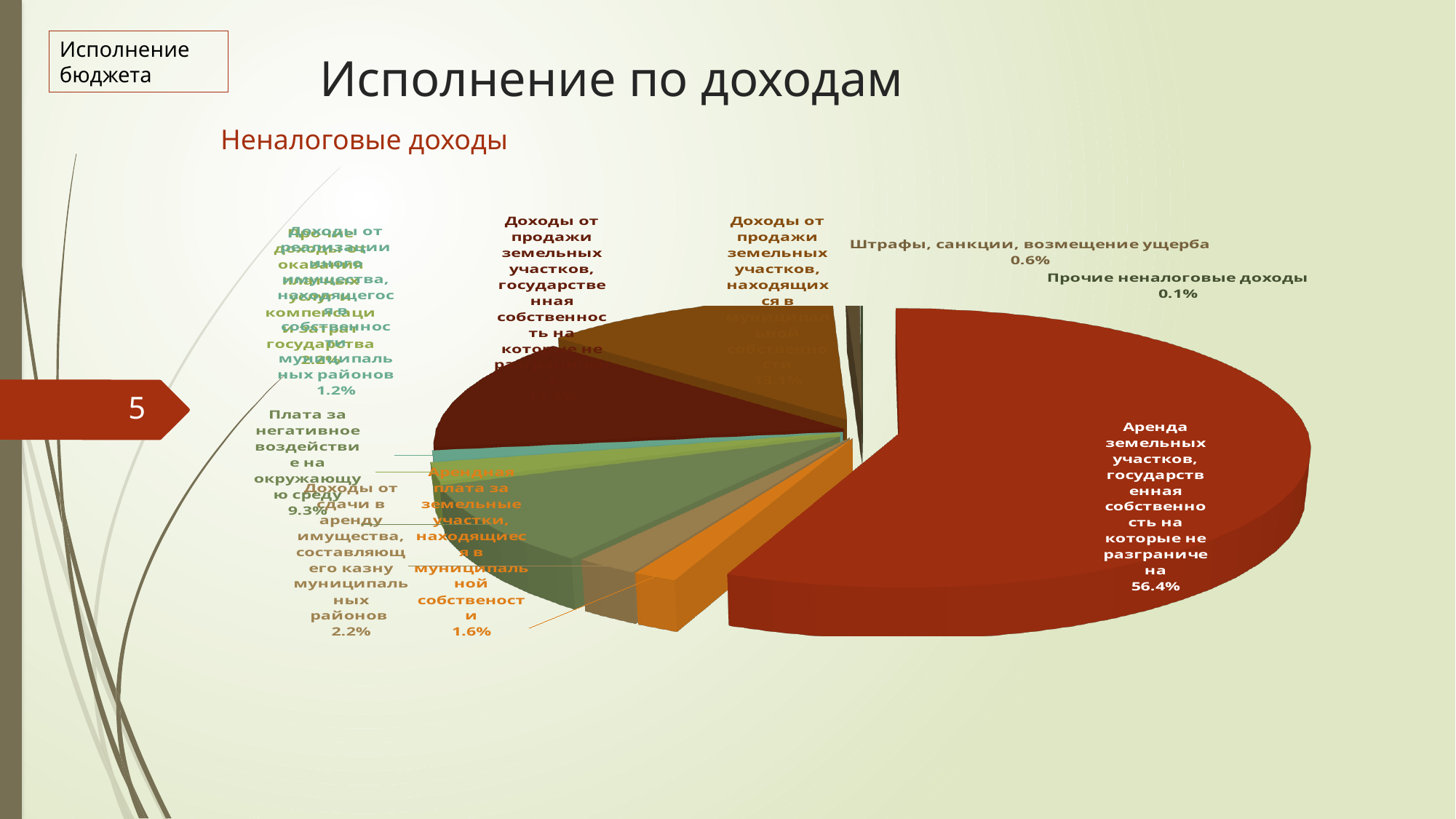
By how many percentage points does the share for "Аренда земельных участков, государственная собственность на которые не разграничена" exceed the share for "Плата за негативное воздействие на окружающую среду"? 47.1 percentage points Which category has the smallest labelled share? Прочие неналоговые доходы Which category has the largest slice of the pie? Аренда земельных участков, государственная собственность на которые не разграничена What share is shown for "Прочие неналоговые доходы"? 0.1% What share is shown for "Плата за негативное воздействие на окружающую среду"? 9.3% What share is shown for "Штрафы, санкции, возмещение ущерба"? 0.6% What share is shown for "Арендная плата за земельные участки, находящиеся в муниципальной собственности"? 1.6% What is the title of the chart? Неналоговые доходы What kind of chart is shown on the slide? Pie chart Which is larger: the share for "Штрафы, санкции, возмещение ущерба" or for "Прочие неналоговые доходы"? Штрафы, санкции, возмещение ущерба What share of the pie is labelled for "Аренда земельных участков, государственная собственность на которые не разграничена"? 56.4% What share is shown for "Доходы от сдачи в аренду имущества, составляющего казну муниципальных районов"? 2.2%